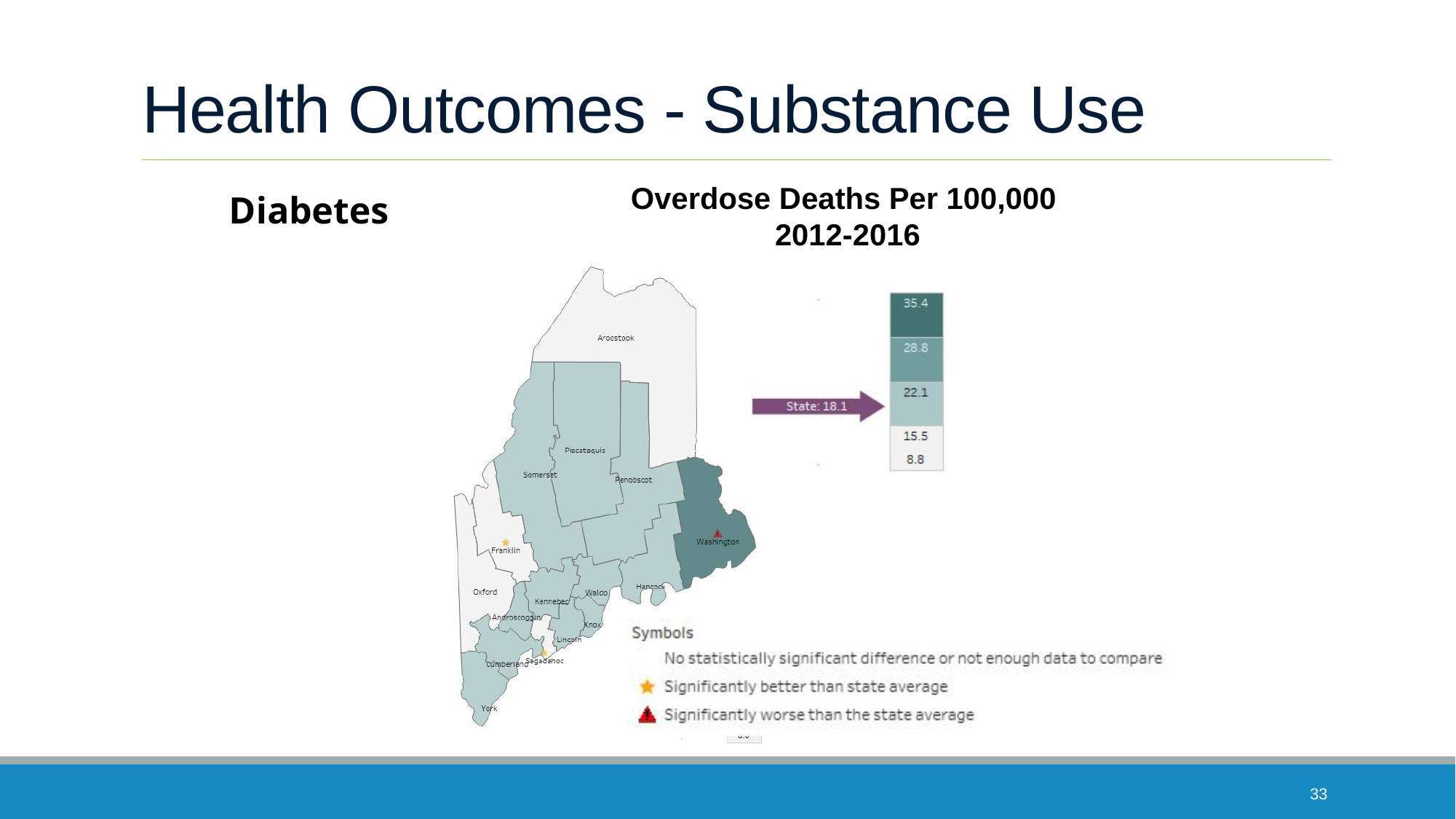
Is the state value of 18.1 greater or less than the 22.1 mark on the colour scale? less What does the star symbol mean according to the Symbols key? Significantly better than state average How many values are labelled on the colour scale legend? 5 What kind of chart is shown on the slide? A map (choropleth map of Maine counties) What is the difference between the highest and lowest values on the colour scale legend? 26.6 What is the state value shown by the arrow next to the colour scale? State: 18.1 Which counties are marked with a star as significantly better than the state average? Franklin and Sagadahoc What is the title of the map chart? Overdose Deaths Per 100,000 2012-2016 Which county is marked with a red triangle as significantly worse than the state average? Washington What is the highest value shown on the colour scale legend? 35.4 Which county is shaded darkest on the map, indicating the highest overdose death rate? Washington What is the lowest value shown on the colour scale legend? 8.8